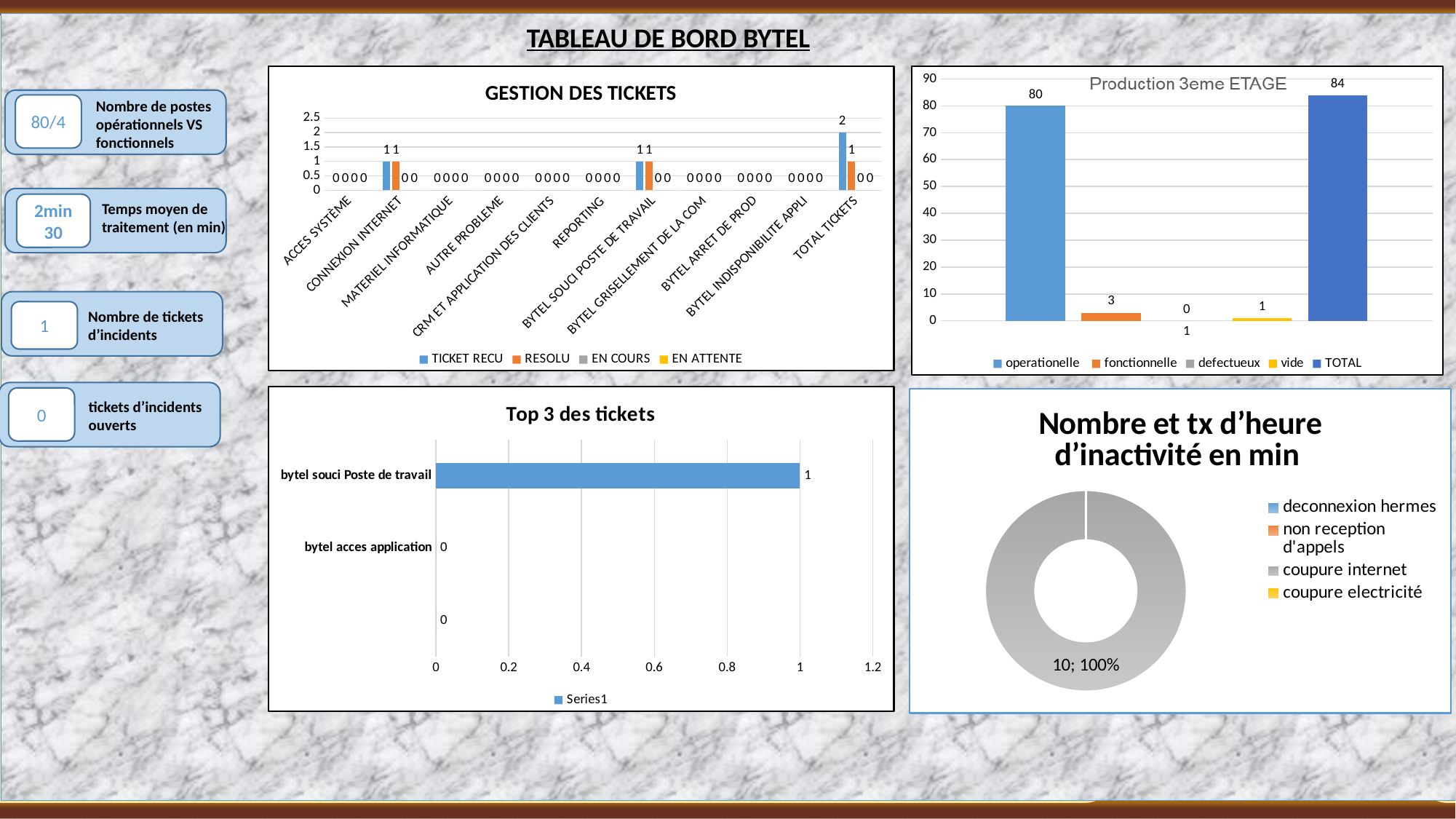
In the 'GESTION DES TICKETS' chart, how many series does the legend list? 4 In the 'Production 3eme ETAGE' chart, what is the value for TOTAL? 84 In the 'Top 3 des tickets' chart, what is the value for bytel souci Poste de travail? 1 In the 'GESTION DES TICKETS' chart, which category has the highest TICKET RECU value? TOTAL TICKETS In the 'Production 3eme ETAGE' chart, which series has the highest value? TOTAL In the 'Production 3eme ETAGE' chart, what is the value for operationnelle? 80 In the 'Nombre et tx d'heure d'inactivité en min' chart, what share does coupure internet have? 100% What kind of chart is 'Top 3 des tickets'? Bar chart In the 'GESTION DES TICKETS' chart, what is the TICKET RECU value for TOTAL TICKETS? 2 In the 'Production 3eme ETAGE' chart, how many series does the legend list? 5 In the 'Production 3eme ETAGE' chart, what is the difference between TOTAL and operationnelle? 4 In the 'Production 3eme ETAGE' chart, what is the value for fonctionnelle? 3